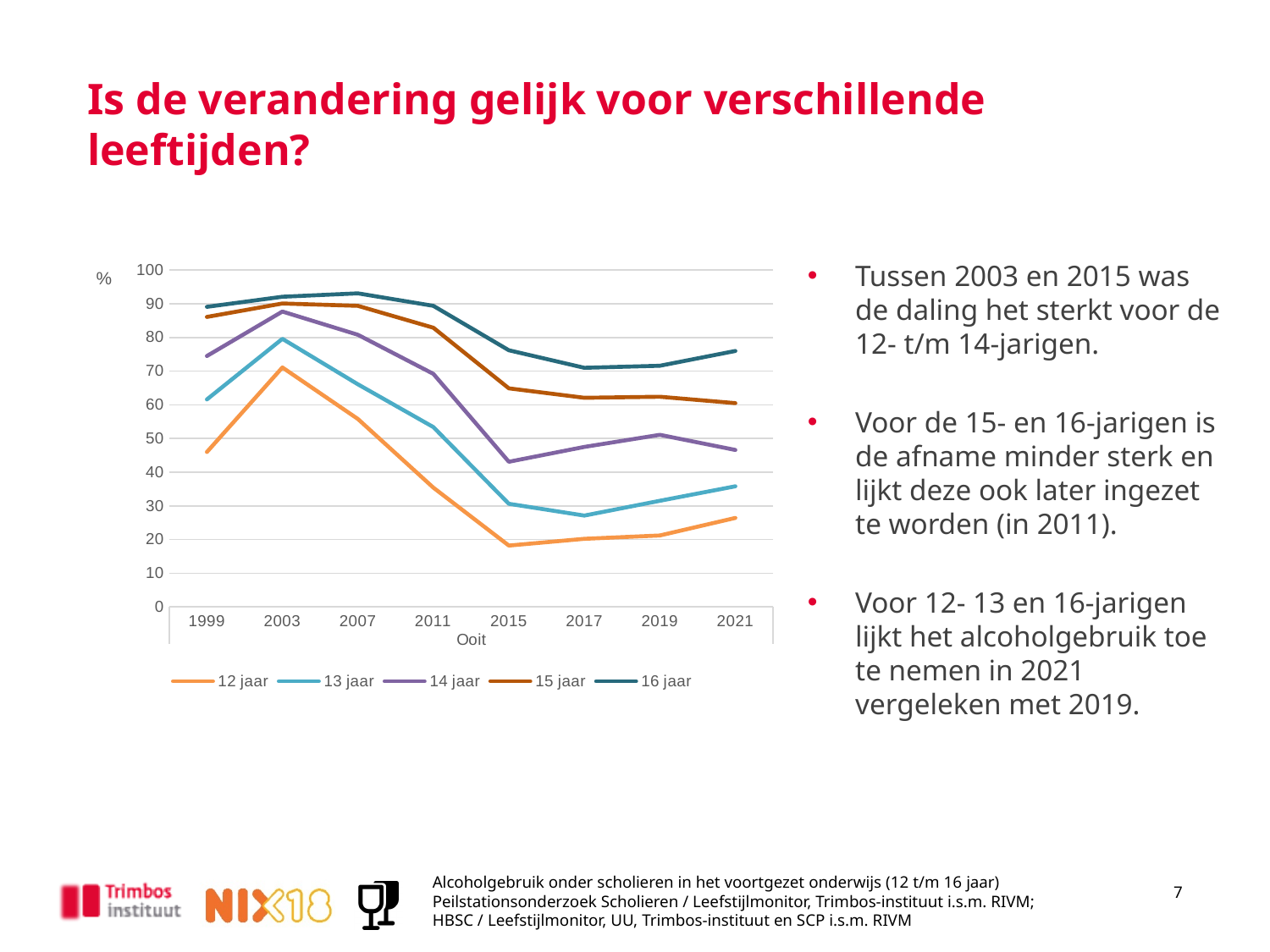
What is the label on the x axis of the chart? Ooit What kind of chart is shown on the slide? line chart Which age group has the lowest value in 1999? 12 jaar Which age group has the highest value in 2021? 16 jaar In 2015, which is larger: the value for 14 jaar or for 13 jaar? 14 jaar Does the line for 12 jaar rise or fall between 2003 and 2015? fall How many series does the legend list? 5 Is the value for 14 jaar in 2015 greater or less than 50? less Is the value for 16 jaar in 2007 greater or less than 80? greater What unit is shown on the y axis of the chart? % Is the value for 12 jaar in 2003 greater or less than 60? greater How many years are shown along the x axis? 8